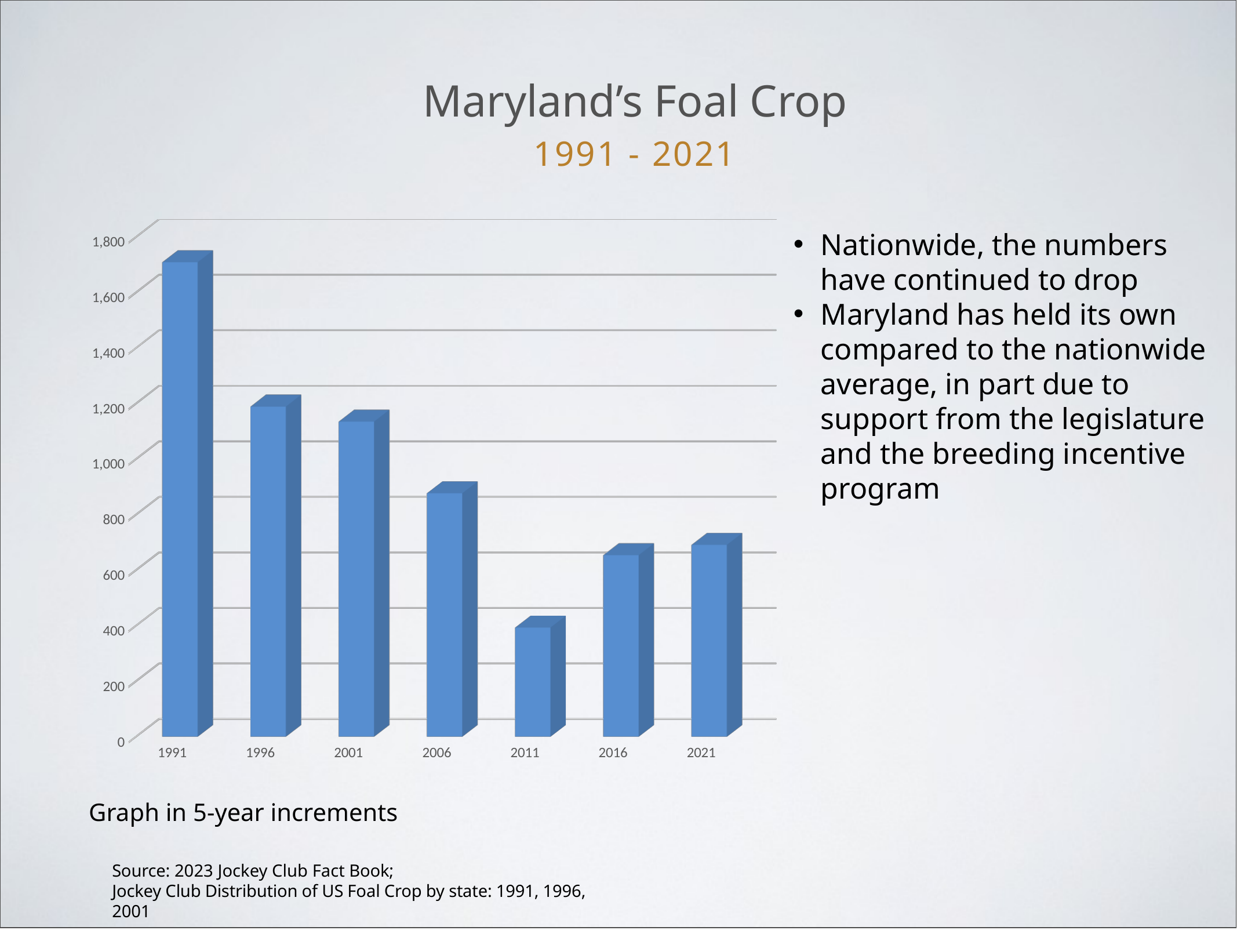
Which is larger, the value for 2006 or the value for 2016? 2006 How many years are plotted on the chart? 7 What kind of chart is shown on the slide? bar chart Is the value for 2006 greater or less than 1,000? less Is the value for 1996 greater or less than 1,400? less Do the values fall or rise from 1991 to 2011? fall Is the value for 2001 greater or less than 1,000? greater Which year has the highest foal crop? 1991 Which year has the lowest foal crop? 2011